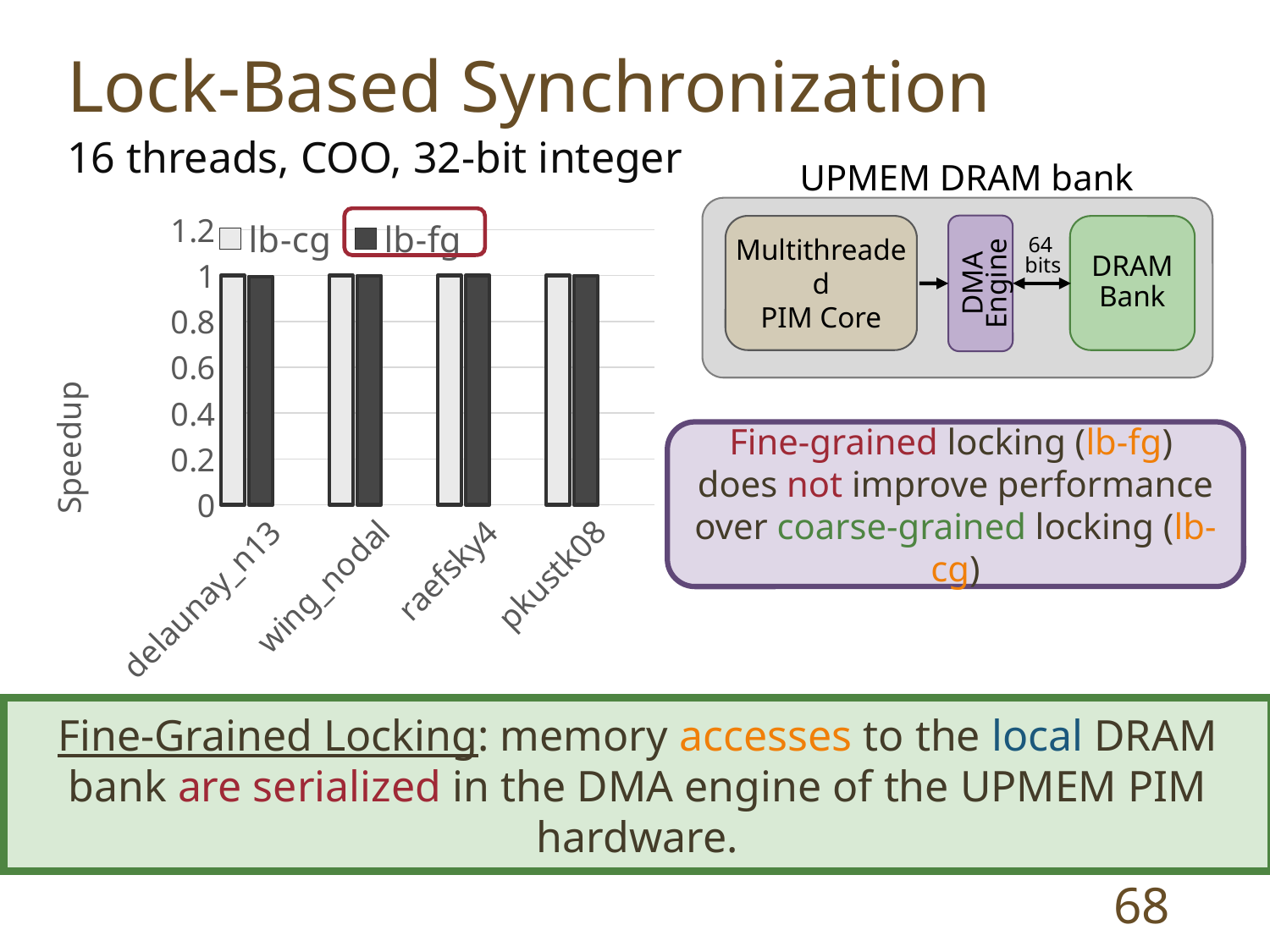
What kind of chart is shown on the slide? bar chart Do the lb-fg speedup values rise, fall, or stay flat across the categories on the x axis? stay flat How many series does the chart's legend list? 2 How many categories (matrices) are shown on the x axis of the chart? 4 What is the label of the chart's y axis? Speedup What is the speedup of lb-cg for delaunay_n13? 1 What is the highest tick value shown on the chart's y axis? 1.2 What is the speedup of lb-fg for pkustk08? 1 Is the speedup of lb-fg for wing_nodal greater or less than 0.8? greater What are the two series named in the chart's legend? lb-cg and lb-fg Is the speedup of lb-fg for delaunay_n13 greater or less than 0.6? greater Is the speedup of lb-cg for raefsky4 greater or less than 1.2? less